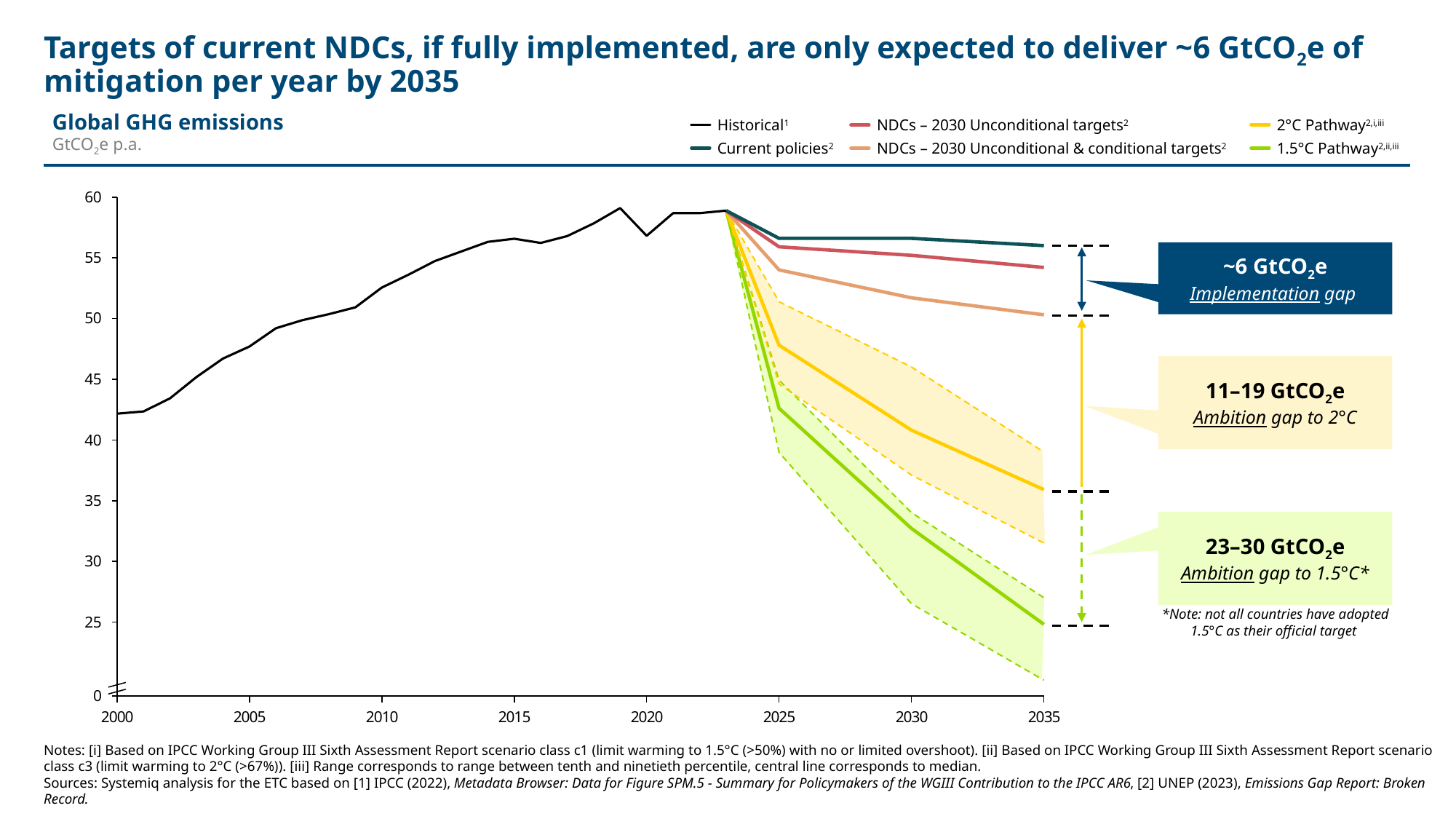
What unit is shown under the chart title? GtCO2e p.a. What kind of chart is shown on the slide? Line chart Which series has the lowest value in 2035? 1.5°C Pathway Does the Historical series rise or fall between 2000 and 2023? Rise What is the size of the Ambition gap to 1.5°C labelled on the chart? 23–30 GtCO2e What is the title of the chart? Global GHG emissions What is the size of the Ambition gap to 2°C labelled on the chart? 11–19 GtCO2e Is the value of the 2°C Pathway in 2035 greater or less than 40? less What is the size of the Implementation gap labelled on the chart? ~6 GtCO2e How many series does the legend list? 6 In 2035, which is larger: Current policies or the 1.5°C Pathway? Current policies Which series has the highest value in 2035? Current policies